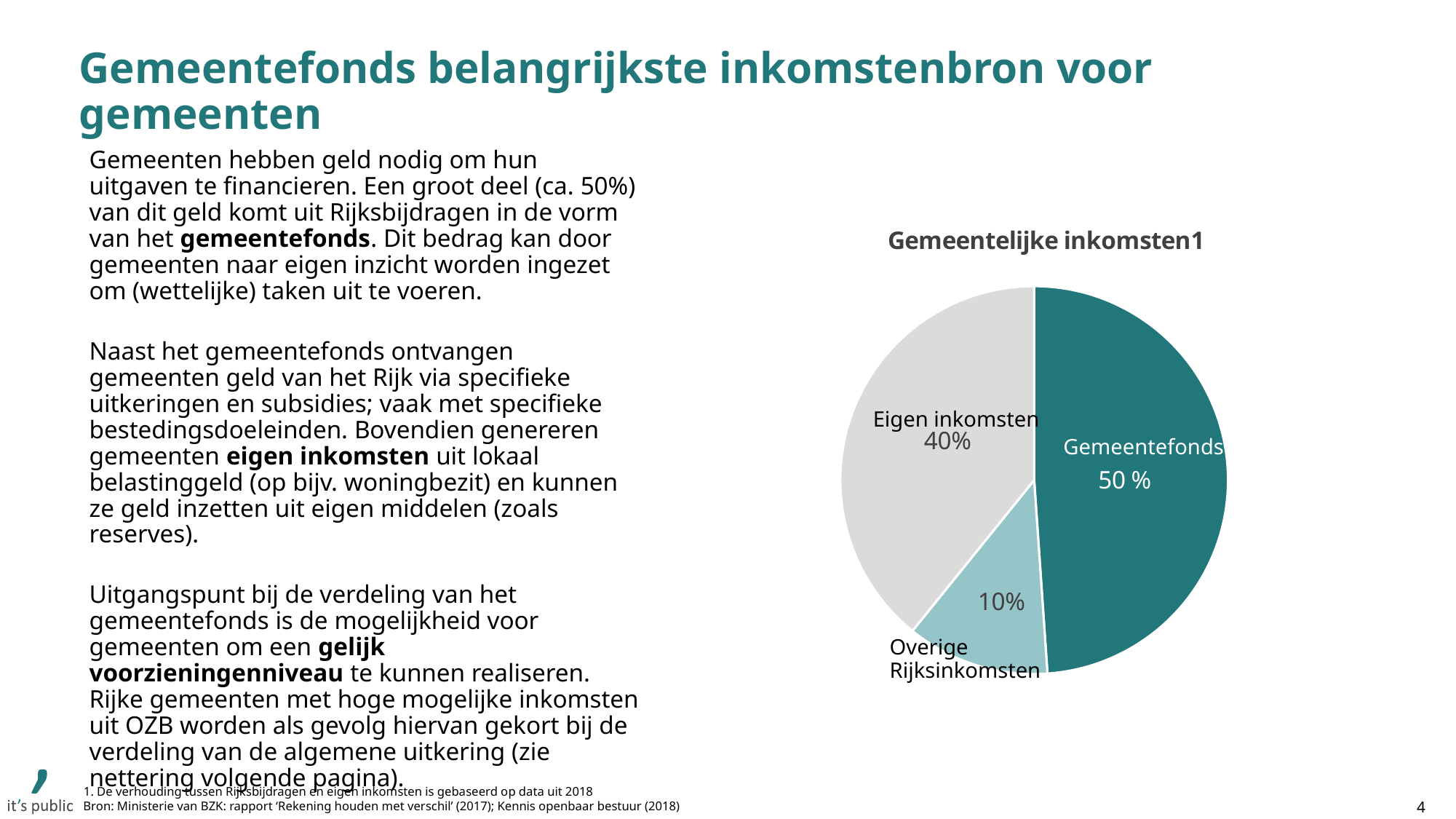
What is the title of the chart? Gemeentelijke inkomsten1 What is the difference in percentage points between Eigen inkomsten and Overige Rijksinkomsten? 30 What kind of chart is shown on the slide? pie chart What share of the pie does Gemeentefonds represent? 50 % What colour is the Gemeentefonds slice? dark teal What share of the pie does Overige Rijksinkomsten represent? 10% Which slice of the pie is the largest? Gemeentefonds How many slices does the pie chart have? 3 Which is larger, the Eigen inkomsten slice or the Overige Rijksinkomsten slice? Eigen inkomsten What share of the pie does Eigen inkomsten represent? 40% Which slice of the pie is the smallest? Overige Rijksinkomsten What is the difference in percentage points between Gemeentefonds and Eigen inkomsten? 10